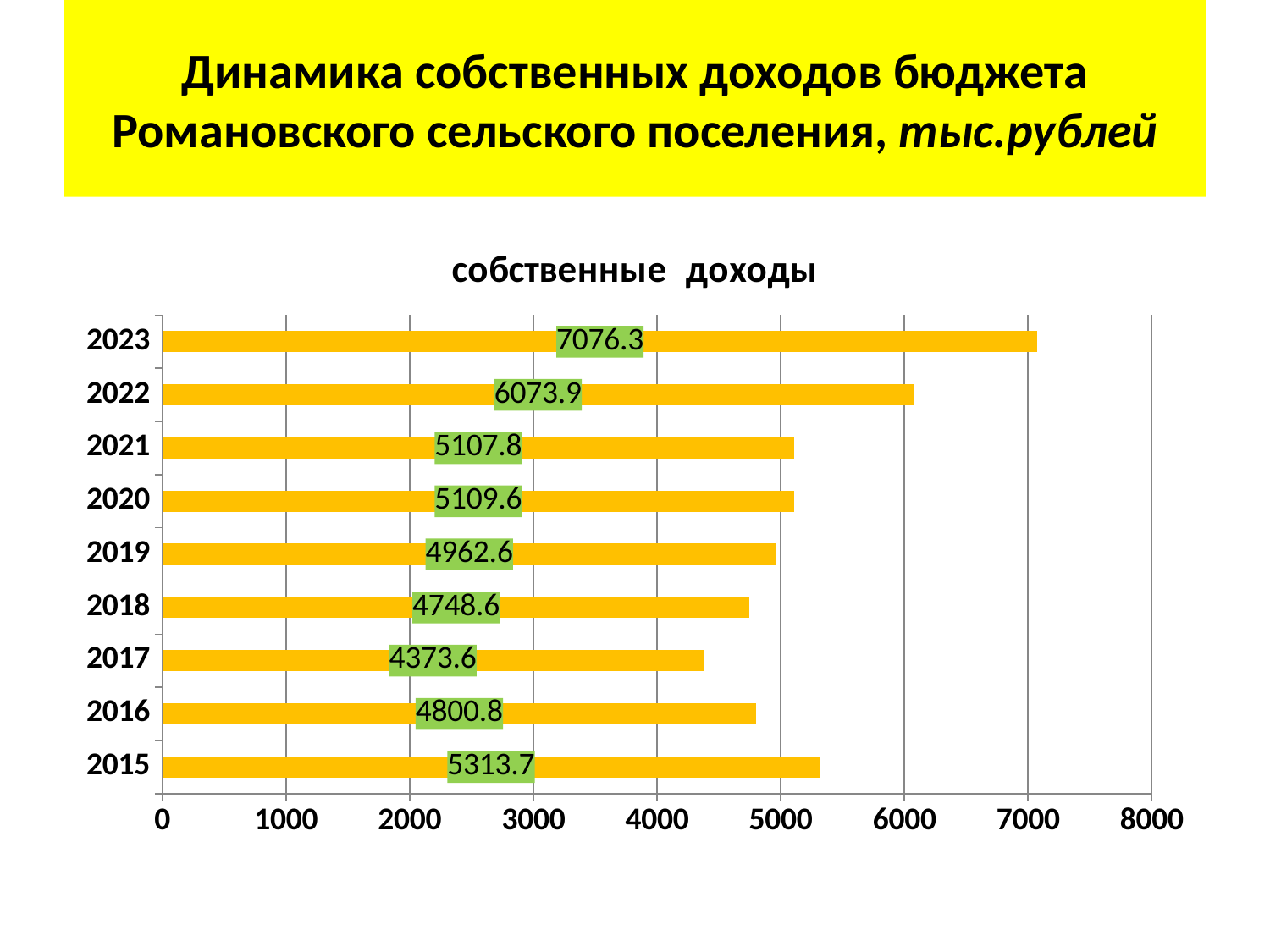
Which year has the lowest value? 2017 What is the value for 2015? 5313.7 How many years are shown in the chart? 9 What is the value for 2017? 4373.6 What is the value for 2023? 7076.3 What kind of chart is shown on the slide? bar chart What is the difference between the values for 2015 and 2016? 512.9 Which is larger, the value for 2019 or the value for 2017? 2019 Is the value for 2022 greater or less than 6000? greater What is the difference between the values for 2023 and 2022? 1002.4 What is the title of the chart? собственные доходы Which year has the highest value? 2023